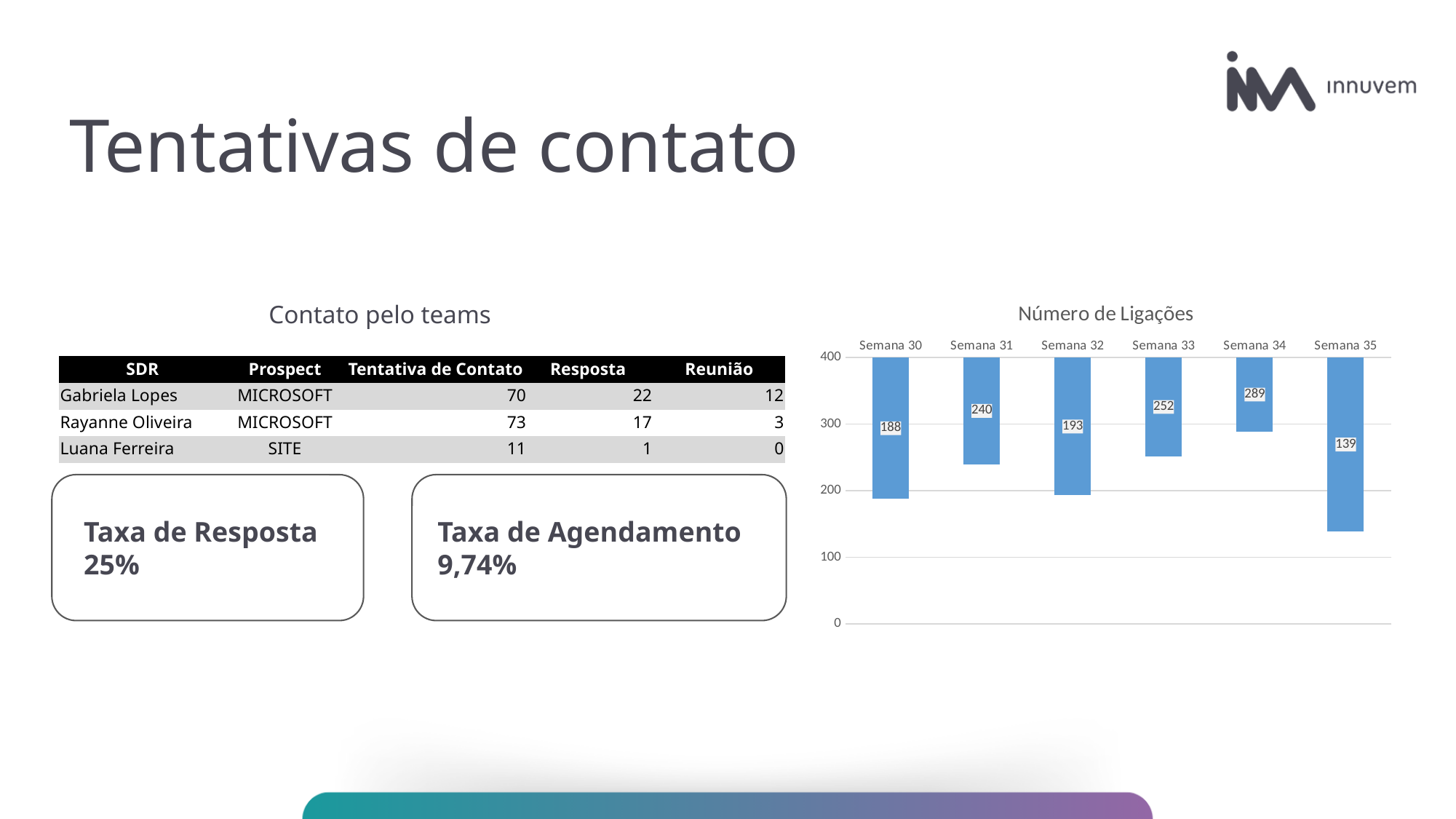
What is the difference between the values for Semana 31 and Semana 30 in the Número de Ligações chart? 52 What is the value for Semana 35 in the Número de Ligações chart? 139 Which is larger in the Número de Ligações chart, Semana 32 or Semana 33? Semana 33 How many weeks are shown in the Número de Ligações chart? 6 What is the difference between the values for Semana 34 and Semana 35 in the Número de Ligações chart? 150 Which week has the lowest value in the Número de Ligações chart? Semana 35 What is the title of the chart on the slide? Número de Ligações What is the value for Semana 33 in the Número de Ligações chart? 252 What is the value for Semana 30 in the Número de Ligações chart? 188 What kind of chart is the Número de Ligações chart? Bar chart Is the value for Semana 31 in the Número de Ligações chart greater or less than 200? greater Which week has the highest value in the Número de Ligações chart? Semana 34